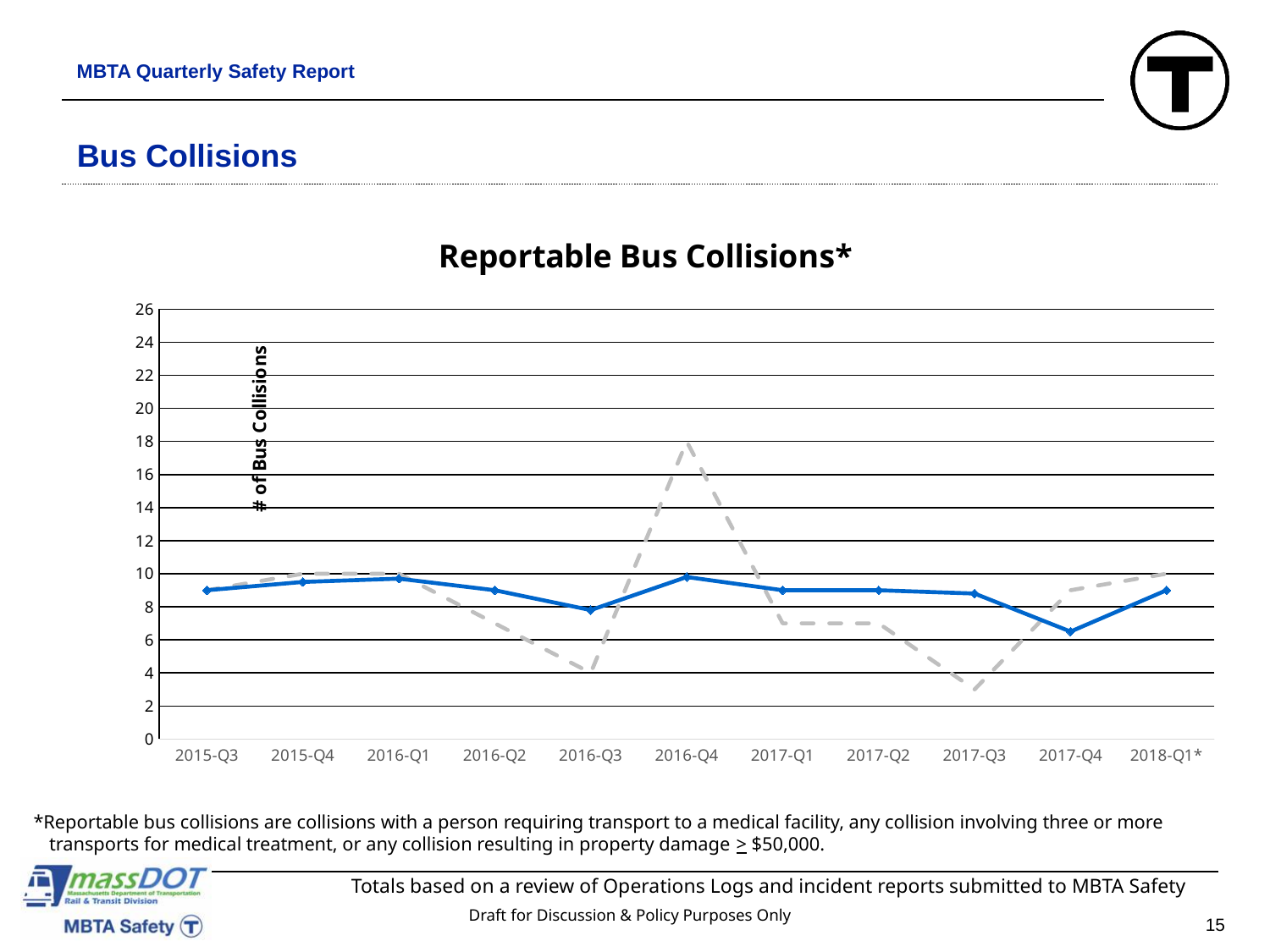
What is the label on the vertical axis of the chart? # of Bus Collisions What is the title of the chart? Reportable Bus Collisions* Is the value of the dashed gray line for 2016-Q3 greater or less than 6? less In which quarter does the dashed gray line reach its highest value? 2016-Q4 How many quarters are plotted along the x axis of the chart? 11 Does the dashed gray line rise or fall from 2016-Q4 to 2017-Q3? fall Is the value of the dashed gray line for 2016-Q4 greater or less than 14? greater What kind of chart is shown on the slide? line chart In which quarter does the solid blue line reach its lowest value? 2017-Q4 Is the value of the solid blue line for 2017-Q4 greater or less than 8? less At 2016-Q4, which line has the higher value, the solid blue line or the dashed gray line? the dashed gray line In which quarter does the dashed gray line reach its lowest value? 2017-Q3